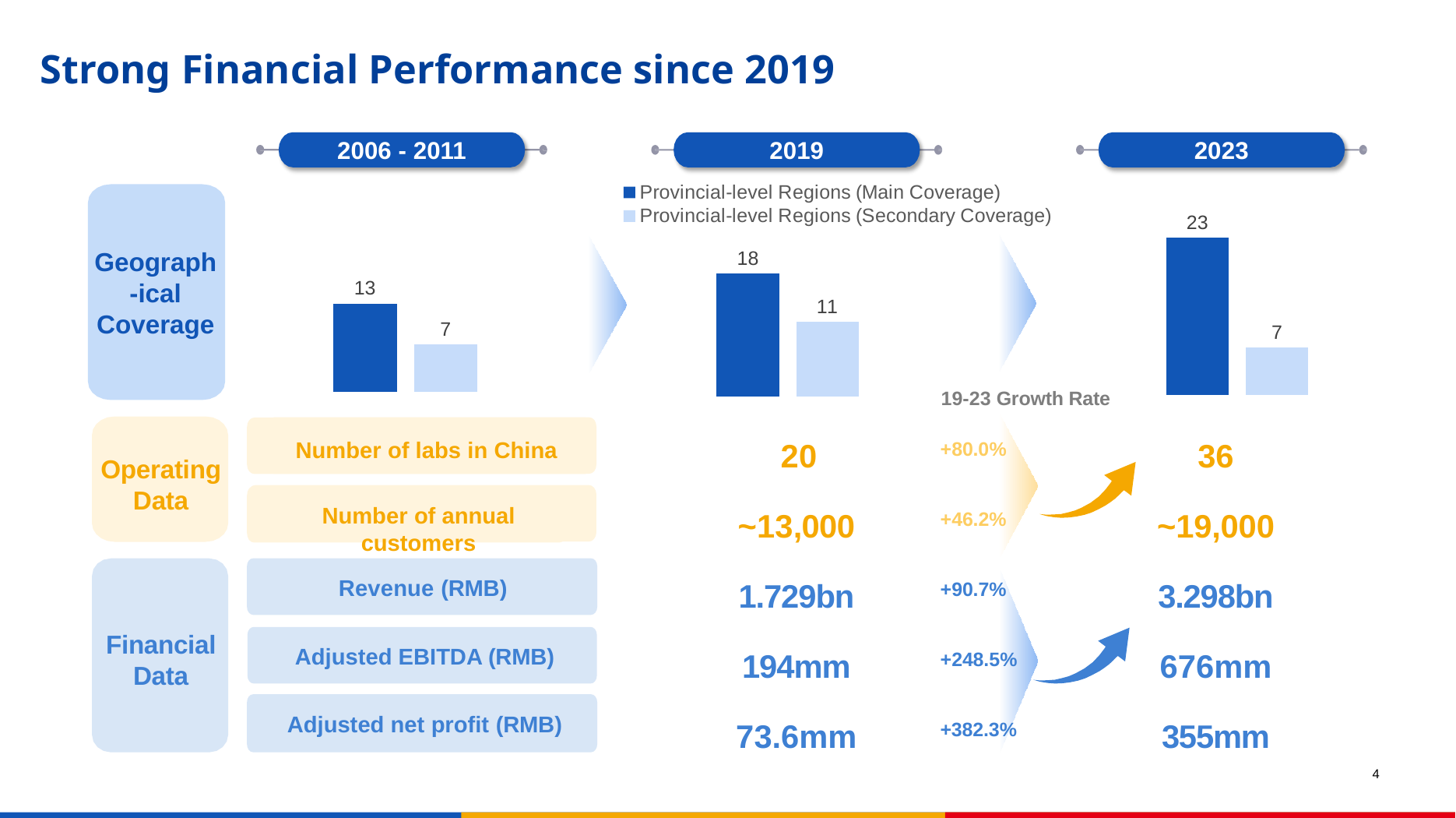
In the Geographical Coverage chart, what is the difference between Main Coverage and Secondary Coverage in 2023? 16 In the Geographical Coverage chart, how much did Provincial-level Regions (Main Coverage) increase from 2006 - 2011 to 2019? 5 In the Geographical Coverage chart, what is the value for Provincial-level Regions (Main Coverage) in 2023? 23 What kind of chart is used for Geographical Coverage? Bar chart In the Geographical Coverage chart, what is the value for Provincial-level Regions (Main Coverage) in 2019? 18 How many series does the legend of the Geographical Coverage chart list? 2 In the Geographical Coverage chart, what is the value for Provincial-level Regions (Secondary Coverage) in 2019? 11 In the Geographical Coverage chart, which is larger: Secondary Coverage in 2019 or Secondary Coverage in 2023? Secondary Coverage in 2019 In the Geographical Coverage chart, which period has the highest value for Provincial-level Regions (Main Coverage)? 2023 In the Geographical Coverage chart, which period has the lowest value for Provincial-level Regions (Main Coverage)? 2006 - 2011 In the Geographical Coverage chart, does the value for Provincial-level Regions (Main Coverage) rise or fall from 2006 - 2011 to 2023? Rise In the Geographical Coverage chart, what is the value for Provincial-level Regions (Secondary Coverage) in 2006 - 2011? 7